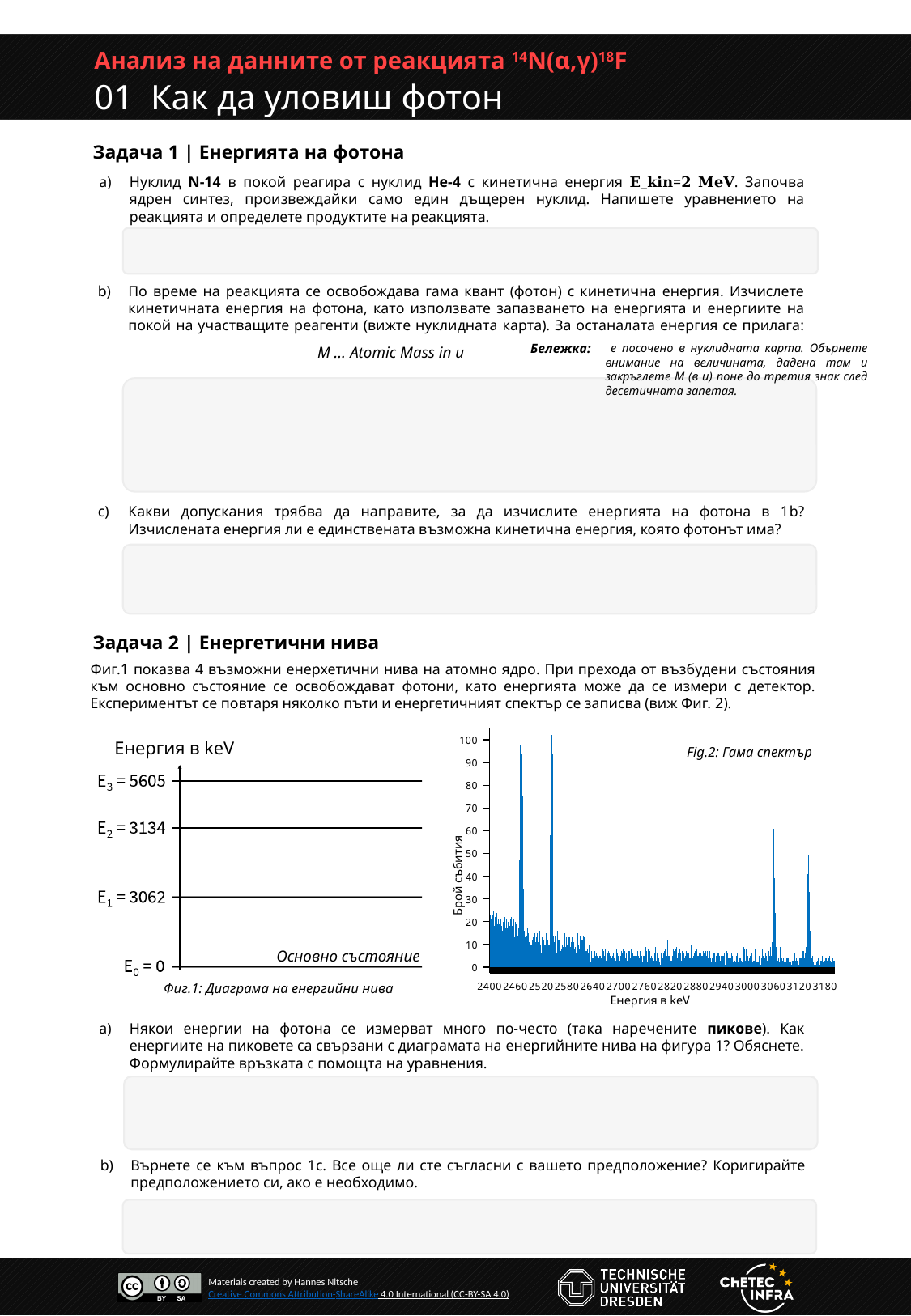
In Fig.1 (Диаграма на енергийни нива), what is the difference in energy between E2 and E1? 72 keV In Fig.2 (Гама спектър), what is the label of the x axis? Енергия в keV In Fig.2 (Гама спектър), which is taller: the peak near 2470 keV or the peak near 3130 keV? the peak near 2470 keV In Fig.2 (Гама спектър), is the height of the tallest peak near 2470 keV greater or less than 90? greater In Fig.1 (Диаграма на енергийни нива), what is the energy of level E3? 5605 keV In Fig.1 (Диаграма на енергийни нива), how many energy levels are shown? 4 In Fig.1 (Диаграма на енергийни нива), what is the energy of level E1? 3062 keV In Fig.1 (Диаграма на енергийни нива), what is the energy of level E2? 3134 keV In Fig.1 (Диаграма на енергийни нива), what is the difference in energy between E3 and E2? 2471 keV In Fig.2 (Гама спектър), what is the label of the y axis? Брой събития In Fig.2 (Гама спектър), is the height of the peak near 3060 keV greater or less than 50? greater In Fig.1 (Диаграма на енергийни нива), which level has the highest energy? E3